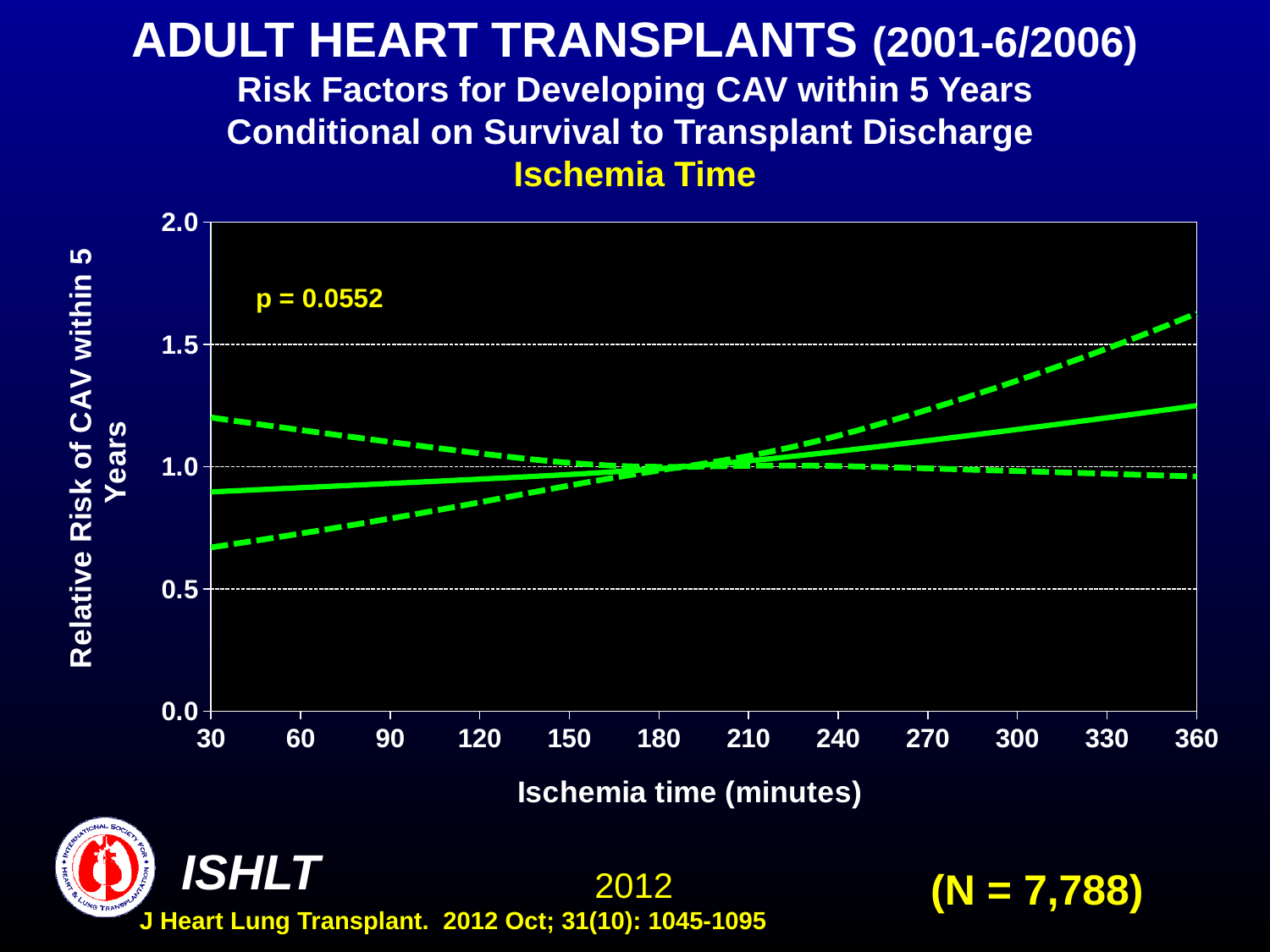
What is the highest value labelled on the y axis? 2.0 Is the value of the solid relative-risk line at an ischemia time of 30 minutes greater or less than 1.0? less How many tick labels are shown on the x axis (ischemia time)? 12 Is the value of the solid relative-risk line at an ischemia time of 360 minutes greater or less than 1.5? less What kind of chart is shown on the slide? line chart What p-value is printed on the chart? p = 0.0552 Does the solid line for relative risk of CAV rise or fall as ischemia time increases from 30 to 360 minutes? rise Is the value of the lower dashed line at an ischemia time of 30 minutes greater or less than 1.0? less